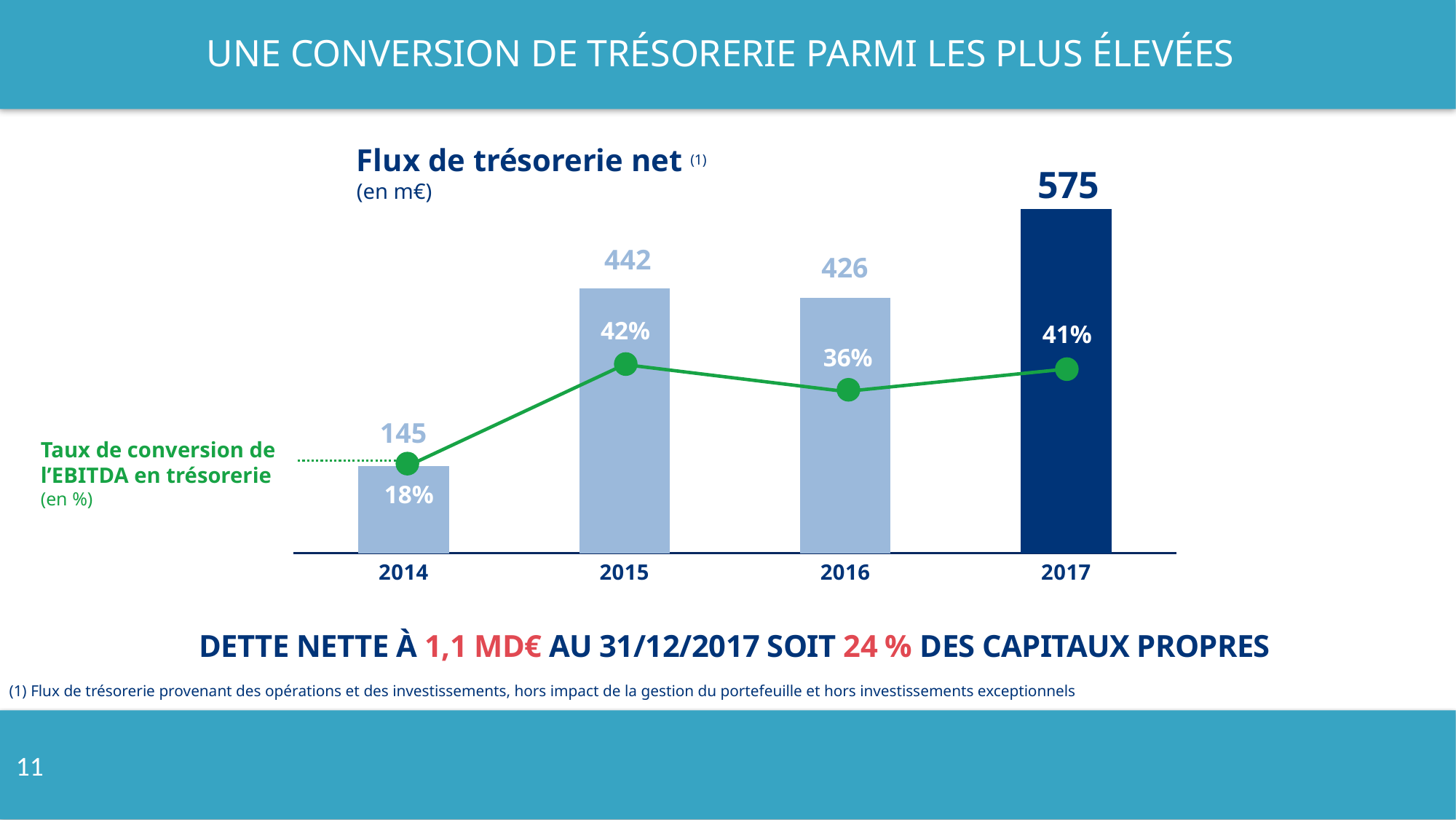
What is the EBITDA-to-cash conversion rate (Taux de conversion) for 2015? 42% Which year has the lowest EBITDA-to-cash conversion rate? 2014 What is the EBITDA-to-cash conversion rate (Taux de conversion) for 2016? 36% How many years are shown on the x axis of the chart? 4 Which year has the highest net cash flow? 2017 What is the net cash flow (Flux de trésorerie net) for 2017? 575 What kind of chart is used to show the net cash flow values? Bar chart Which year has the larger net cash flow, 2015 or 2016? 2015 What is the difference in net cash flow between 2017 and 2016? 149 What is the difference in conversion rate between 2015 and 2014? 24 percentage points What unit is the net cash flow (Flux de trésorerie net) expressed in? m€ What is the net cash flow (Flux de trésorerie net) for 2014? 145